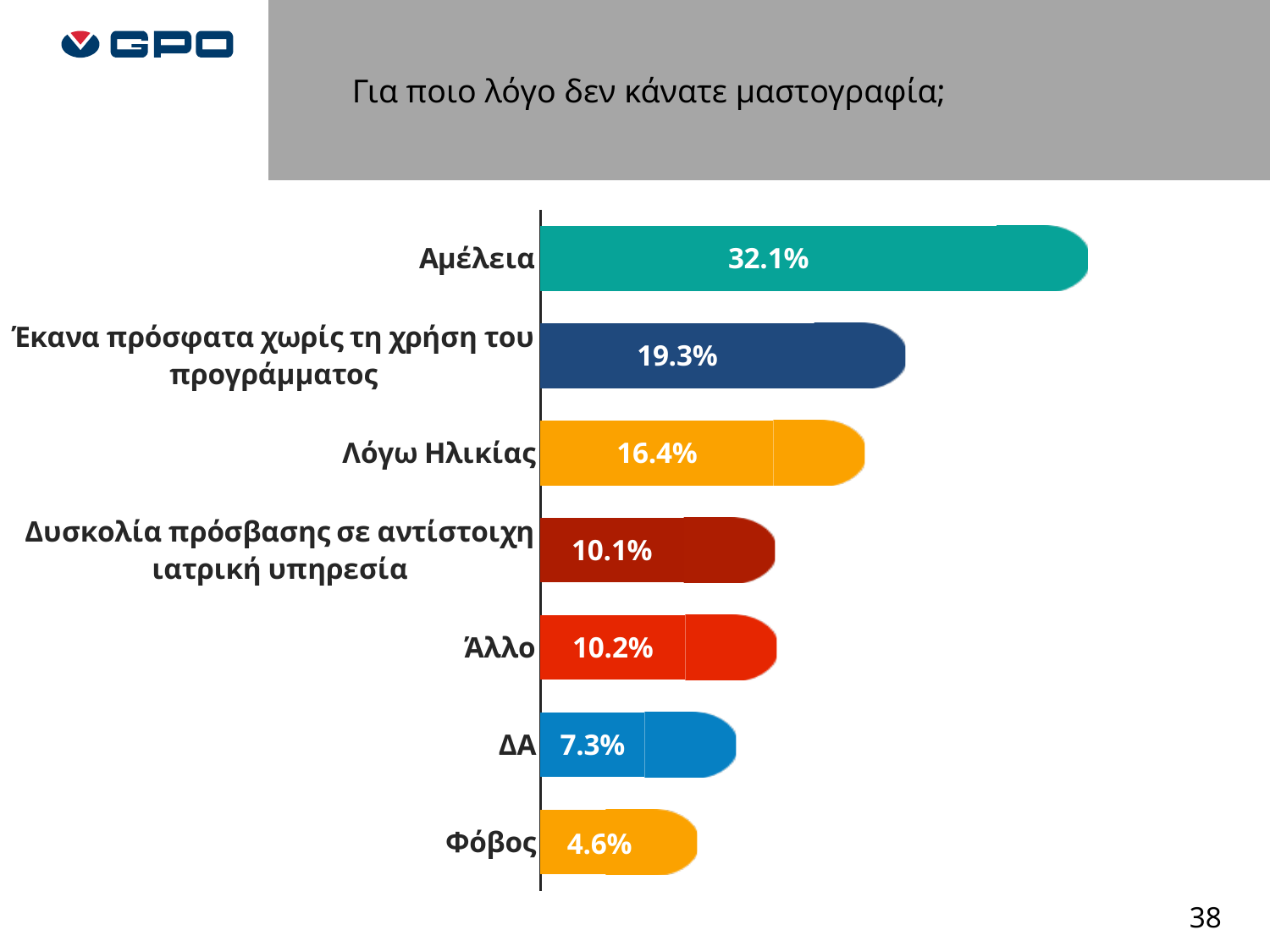
Which is larger, the value for Λόγω Ηλικίας or the value for ΔΑ? Λόγω Ηλικίας Which category has the lowest value? Φόβος What percentage is shown for Αμέλεια? 32.1% What percentage is shown for Λόγω Ηλικίας? 16.4% What is the difference between the values for Λόγω Ηλικίας and Φόβος? 11.8% How many categories are shown in the chart? 7 What is the value for Φόβος? 4.6% What is the value for ΔΑ? 7.3% Which category has the highest value? Αμέλεια What is the difference between the values for Αμέλεια and Έκανα πρόσφατα χωρίς τη χρήση του προγράμματος? 12.8% What kind of chart is shown on the slide? Bar chart What is the title of the slide? Για ποιο λόγο δεν κάνατε μαστογραφία;